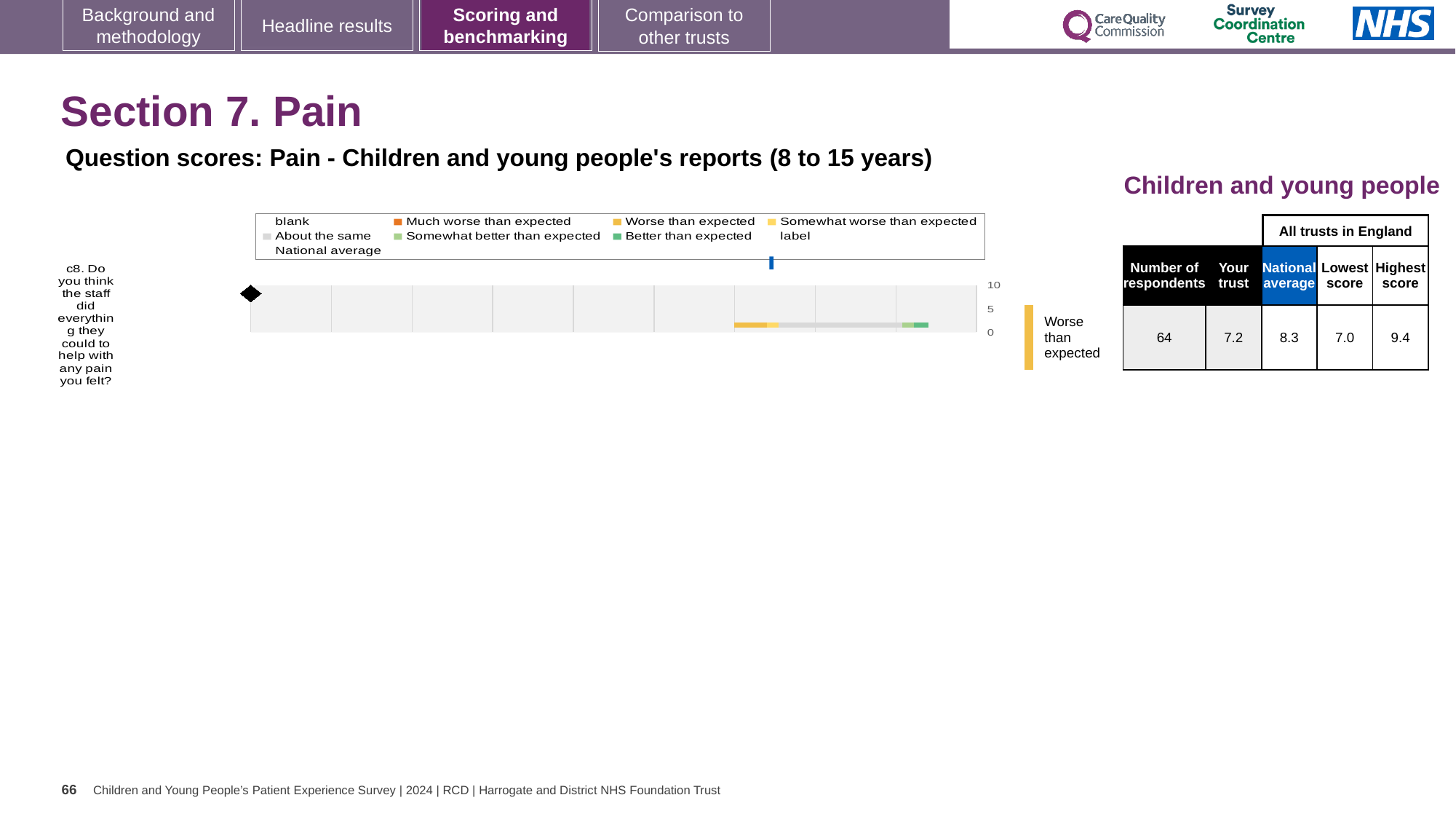
How many entries does the chart's legend list? 9 Which is larger for c8: the 'Your trust' score or the national average? National average In the table beside the chart, what is the lowest score among all trusts in England for c8? 7.0 In the table beside the chart, what is the 'Your trust' score for c8? 7.2 How many respondents answered question c8 according to the table beside the chart? 64 What is the difference between the national average (8.3) and the 'Your trust' score (7.2) for c8? 1.1 What benchmark category is the trust's result for c8 labelled as, next to the chart? Worse than expected Which question is plotted in the chart? c8. Do you think the staff did everything they could to help with any pain you felt? How many questions (categories) are plotted in the chart? 1 What kind of chart is shown on the slide? bar chart In the table beside the chart, what is the highest score among all trusts in England for c8? 9.4 In the table beside the chart, what is the national average score for c8? 8.3